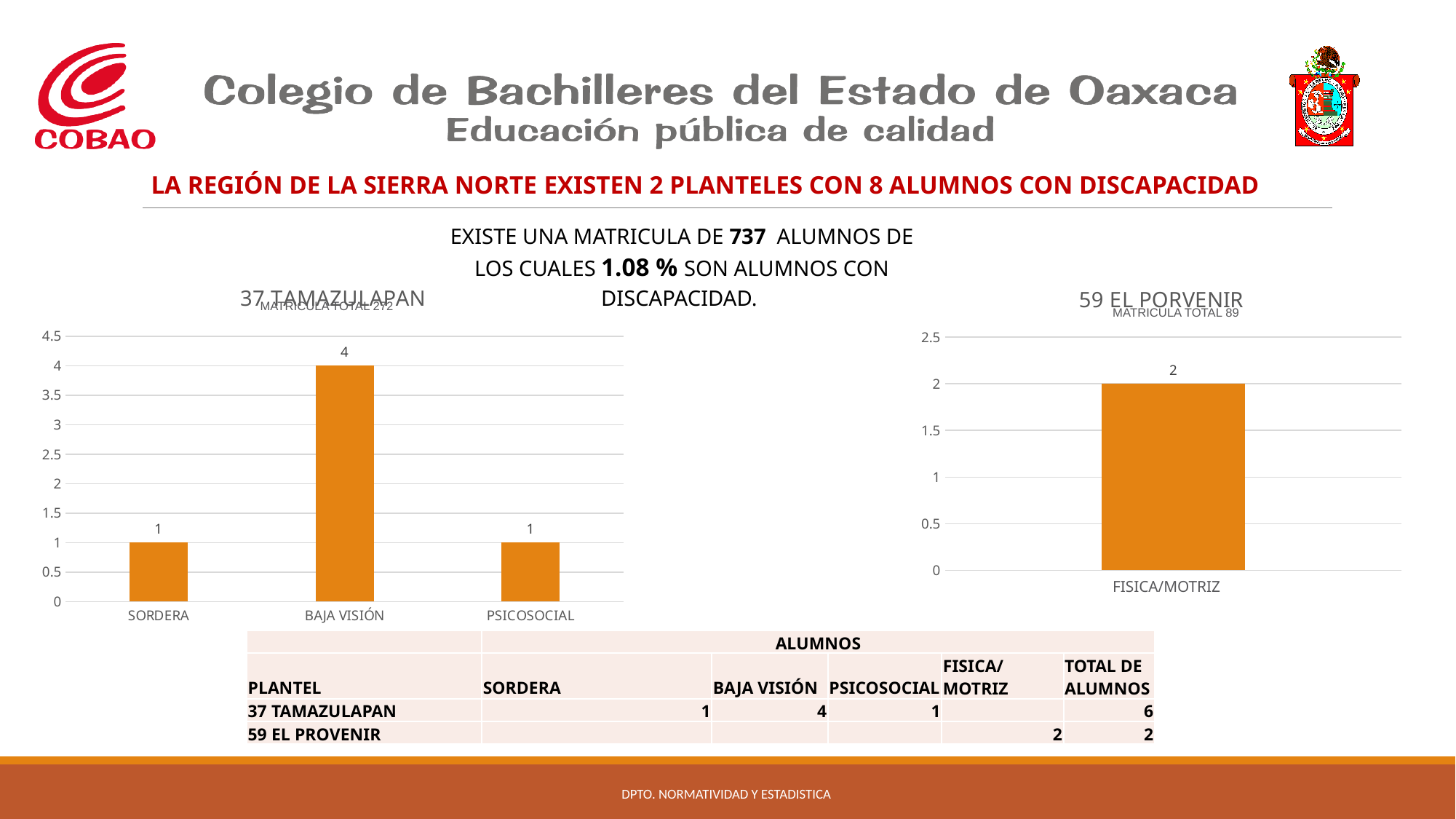
In the 37 TAMAZULAPAN chart, what is the value for SORDERA? 1 In the 37 TAMAZULAPAN chart, which category has the highest value? BAJA VISIÓN In the 37 TAMAZULAPAN chart, which is larger, the value for BAJA VISIÓN or the value for PSICOSOCIAL? BAJA VISIÓN In the 37 TAMAZULAPAN chart, is the value for BAJA VISIÓN greater or less than 3? greater In the 37 TAMAZULAPAN chart, what is the value for PSICOSOCIAL? 1 What kind of chart is the 59 EL PORVENIR chart? Bar chart How many categories are shown in the 37 TAMAZULAPAN chart? 3 In the 59 EL PORVENIR chart, what is the value for FISICA/MOTRIZ? 2 In the 37 TAMAZULAPAN chart, what is the value for BAJA VISIÓN? 4 In the 37 TAMAZULAPAN chart, what is the difference between the values for BAJA VISIÓN and SORDERA? 3 What is the subtitle shown under the title of the 59 EL PORVENIR chart? MATRICULA TOTAL 89 How many categories are shown in the 59 EL PORVENIR chart? 1